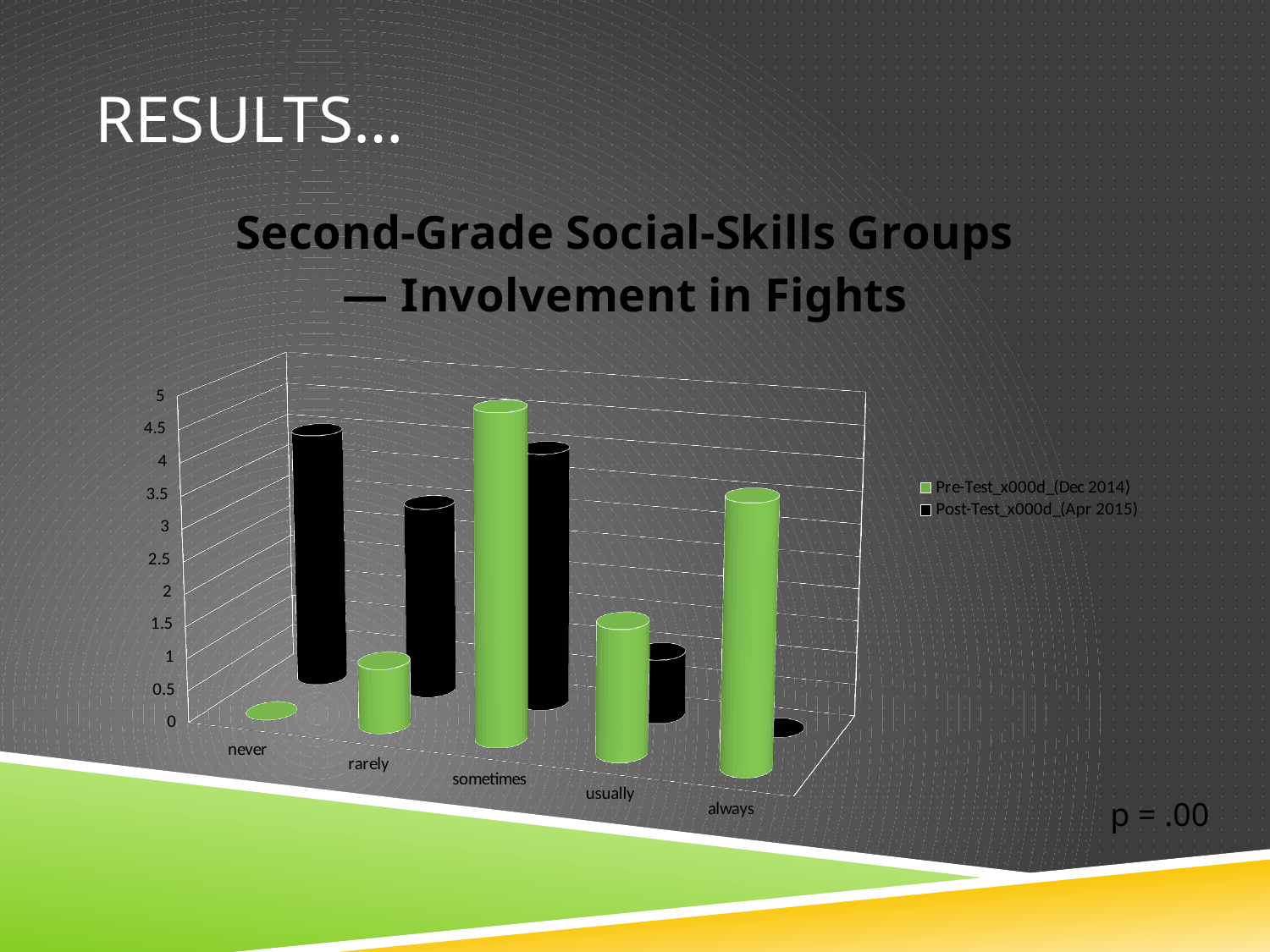
Which category has the highest Pre-Test (Dec 2014) value? sometimes Which colour represents the Post-Test (Apr 2015) series in the chart? black For the 'sometimes' category, which series has the larger value, Pre-Test (Dec 2014) or Post-Test (Apr 2015)? Pre-Test (Dec 2014) How many series does the chart's legend list? 2 Is the Pre-Test (Dec 2014) value for 'sometimes' greater or less than 4? greater What kind of chart is shown on the slide? bar chart How many categories are shown on the x axis of the chart? 5 Which category has the lowest Pre-Test (Dec 2014) value? never Is the Post-Test (Apr 2015) value for 'never' greater or less than 3? greater Is the Pre-Test (Dec 2014) value for 'rarely' greater or less than 2? less Which category has the lowest Post-Test (Apr 2015) value? always For the 'never' category, which series has the larger value, Pre-Test (Dec 2014) or Post-Test (Apr 2015)? Post-Test (Apr 2015)